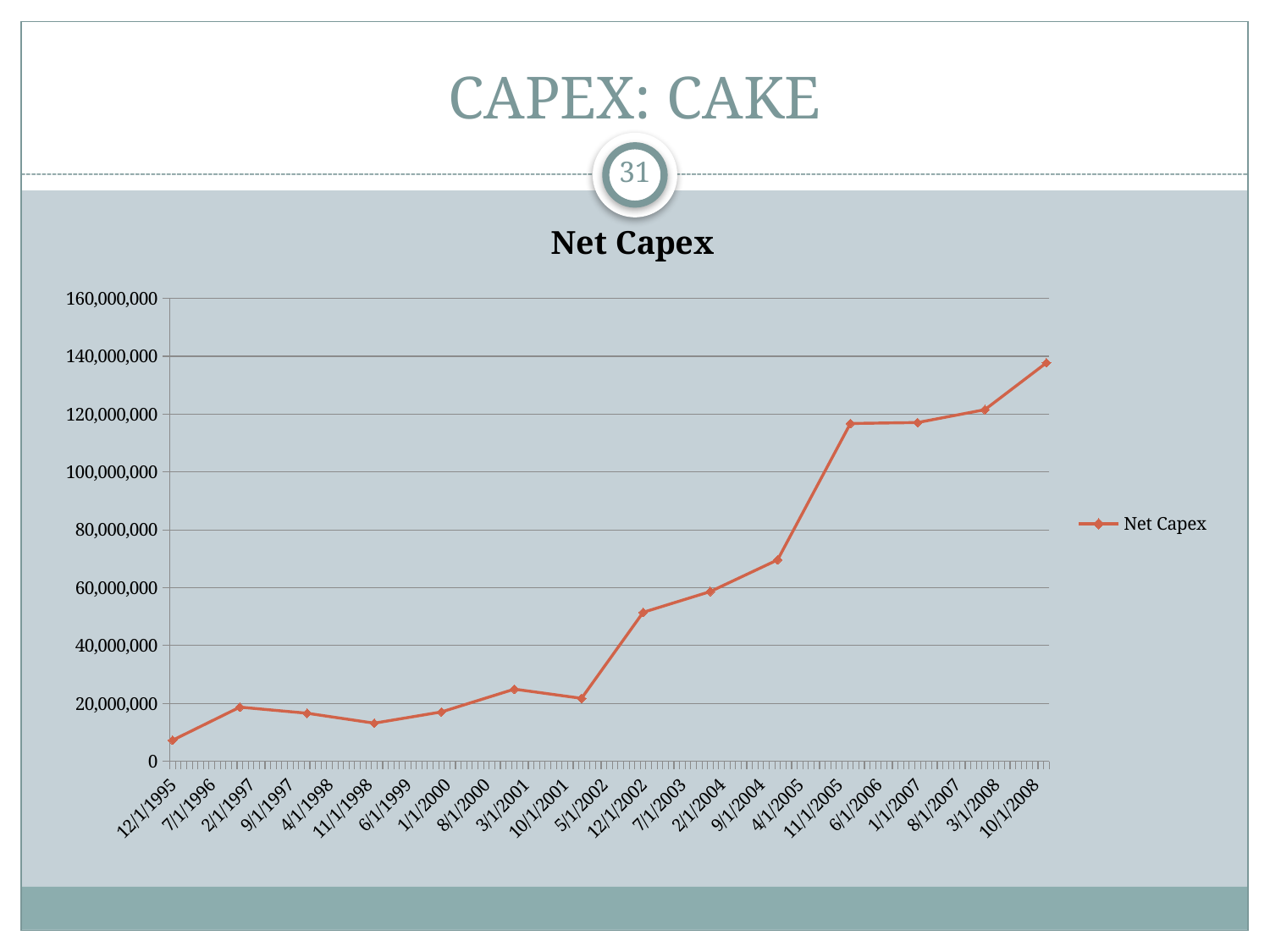
Overall, do the Net Capex values rise or fall from left to right along the x axis? rise How many series does the legend list? 1 Where on the x axis does the lowest Net Capex value occur, at the start or at the end of the series? at the start Is the highest value on the Net Capex line greater or less than 100,000,000? greater Which is larger, the first point or the last point on the Net Capex line? the last point What is the name of the series shown in the legend? Net Capex How many data points are plotted on the Net Capex line? 14 What kind of chart is shown on the slide? line chart Is the value of the first (leftmost) point on the Net Capex line greater or less than 20,000,000? less Is the value of the last (rightmost) point on the Net Capex line greater or less than 120,000,000? greater What is the title of the chart? Net Capex Where on the x axis does the highest Net Capex value occur, at the start or at the end of the series? at the end